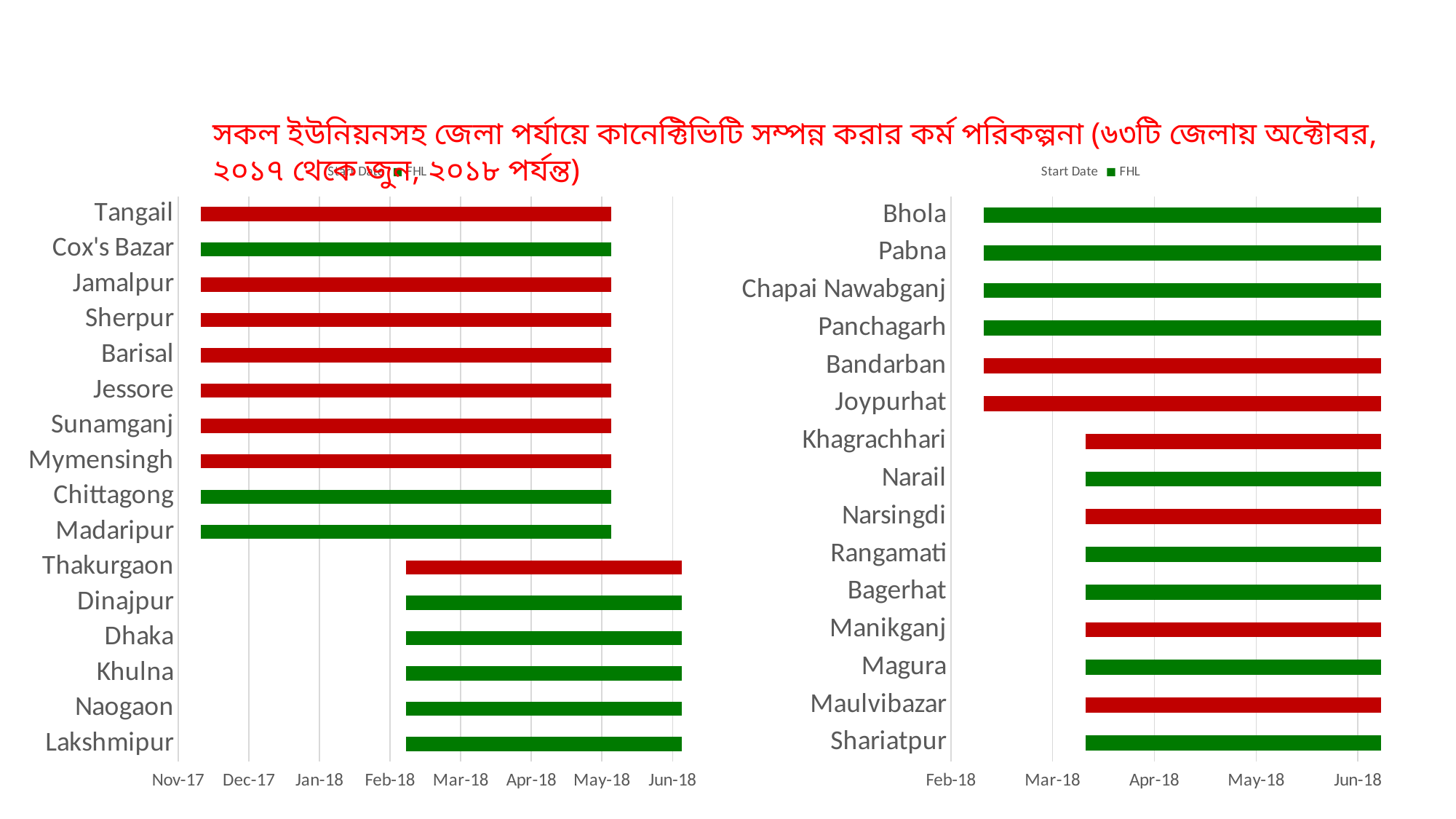
On the left chart, what colour is the bar for Cox's Bazar? green What kind of chart is shown on the left side of the slide? bar chart What are the two legend entries on the right chart? Start Date and FHL How many districts are listed on the left chart? 16 On the right chart, which bar is longer, Bhola or Khagrachhari? Bhola On the left chart, does the bar for Thakurgaon begin before or after Jan-18? after On the right chart, which bar is longer, Joypurhat or Shariatpur? Joypurhat On the right chart, does the bar for Narail begin before or after Mar-18? after How many districts are listed on the right chart? 15 On the left chart, which bar is longer, Tangail or Thakurgaon? Tangail How many series does the legend of the right chart list? 2